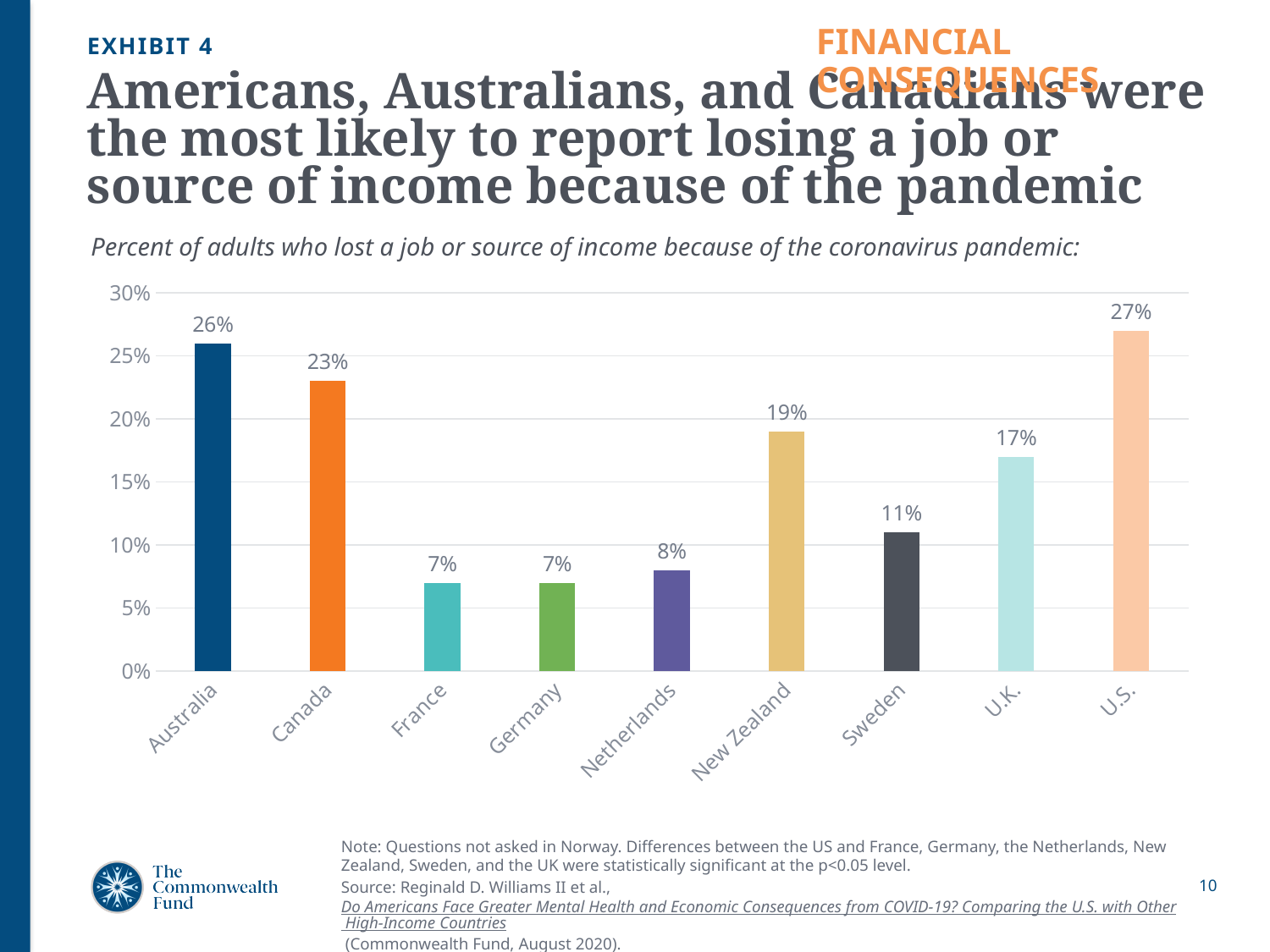
What is the difference between the Australia and Sweden values? 15 percentage points What kind of chart is shown on the slide? Bar chart What is the value shown for Sweden? 11% Which is larger, the value for the U.K. or the value for New Zealand? New Zealand What is the value shown for New Zealand? 19% Is the value for the Netherlands greater or less than 10%? less What is the highest value labelled on the vertical axis? 30% Which country has the lowest value on the chart? France and Germany (7%) What is the difference between the U.S. and Canada values? 4 percentage points What percent of adults in Australia lost a job or source of income because of the pandemic? 26% How many countries are shown on the chart? 9 Which country has the highest percent of adults who lost a job or source of income? U.S.